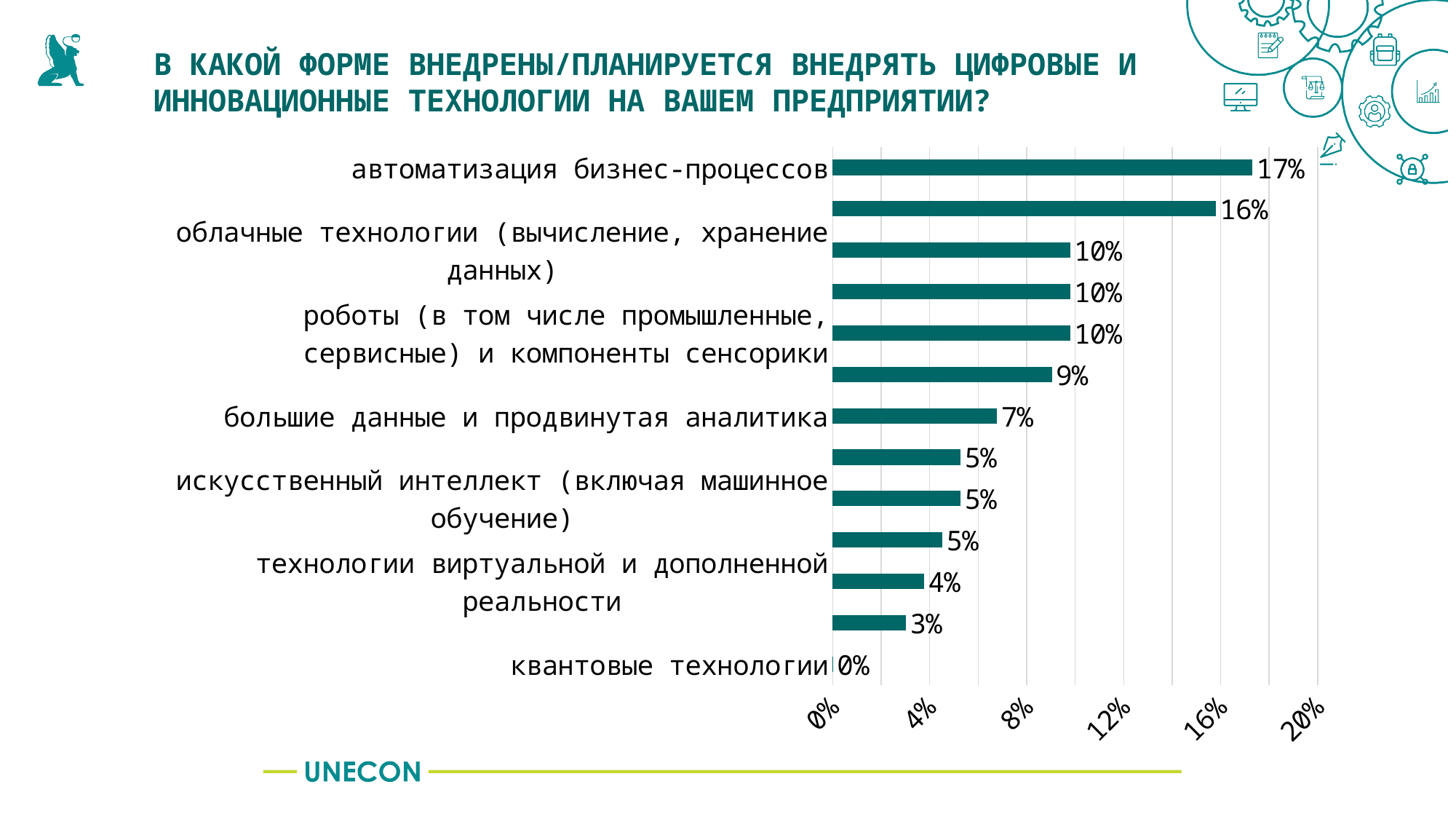
What value is shown for «облачные технологии (вычисление, хранение данных)»? 10% What is the difference between «автоматизация бизнес-процессов» and «большие данные и продвинутая аналитика»? 10% What value is shown for «большие данные и продвинутая аналитика»? 7% Which category has the highest value? автоматизация бизнес-процессов What value is shown for «технологии виртуальной и дополненной реальности»? 4% Which category has the lowest value? квантовые технологии What is the maximum value shown on the horizontal axis? 20% What value is shown for «искусственный интеллект (включая машинное обучение)»? 5% What value is shown for «квантовые технологии»? 0% Which is larger: «роботы (в том числе промышленные, сервисные) и компоненты сенсорики» or «искусственный интеллект (включая машинное обучение)»? роботы (в том числе промышленные, сервисные) и компоненты сенсорики What value is shown for «автоматизация бизнес-процессов»? 17% What kind of chart is shown on the slide? bar chart